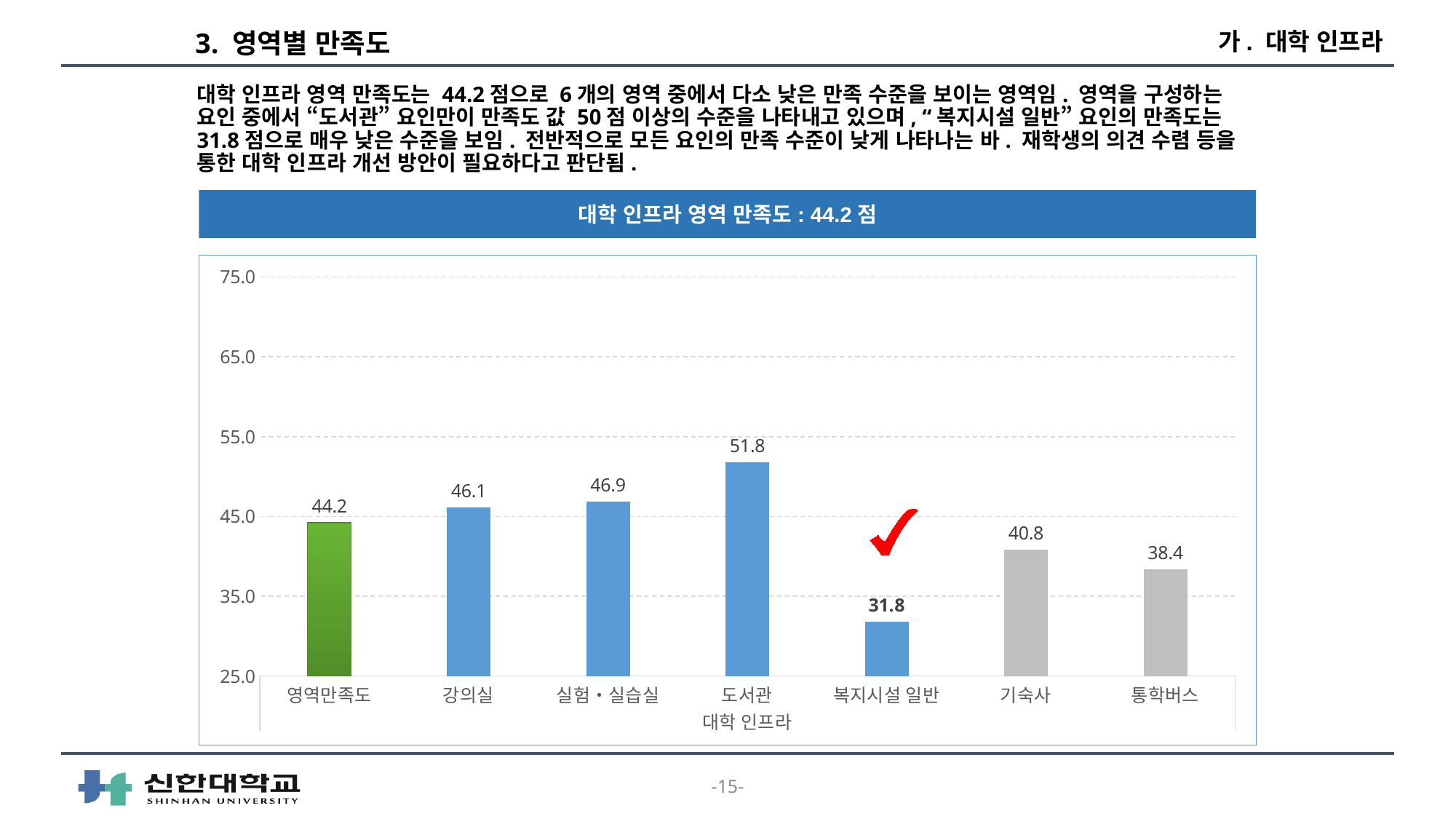
What is the title shown in the banner above the chart? 대학 인프라 영역 만족도 : 44.2 점 What kind of chart is shown on the slide? bar chart What is the value for 도서관? 51.8 What is the value for 통학버스? 38.4 Which category has the highest value? 도서관 What is the value for 복지시설 일반? 31.8 Which is larger, the value for 강의실 or the value for 실험·실습실? 실험·실습실 Which category has the lowest value? 복지시설 일반 What is the value for 기숙사? 40.8 What is the difference between the values for 도서관 and 복지시설 일반? 20.0 How many bars are shown in the chart? 7 Is the value for 기숙사 greater or less than 45.0? less